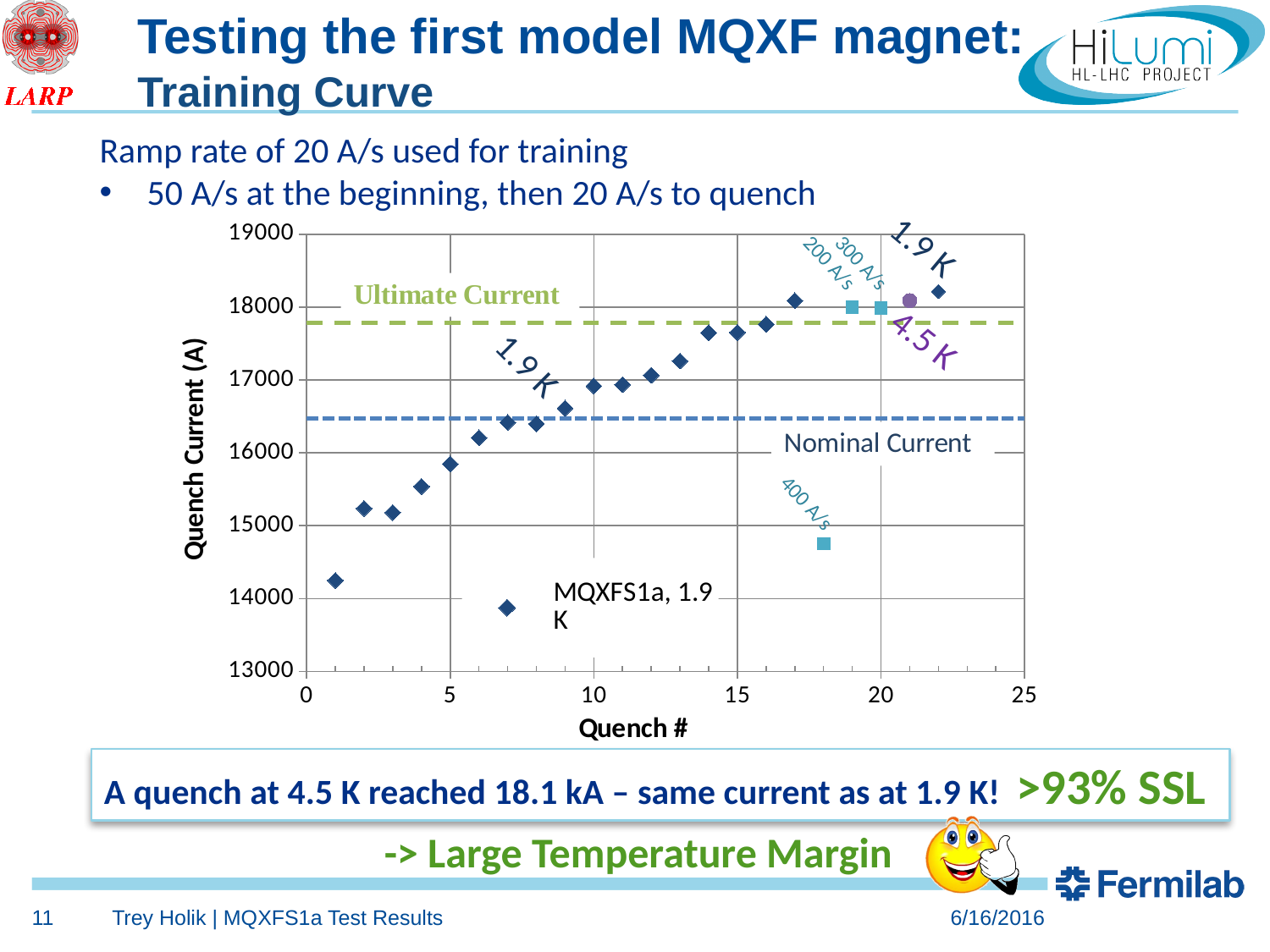
Do the quench currents of the 1.9 K diamond markers generally rise or fall as the quench number increases? rise Is the dashed 'Ultimate Current' line above or below 18000 A? below Which has the larger quench current, quench #1 or quench #2? quench #2 What kind of chart is shown on the slide? scatter chart Is the quench current for quench #1 greater or less than 15000? less Is the quench current for quench #9 greater or less than 16000? greater What label is given to the series of diamond markers in the chart? MQXFS1a, 1.9 K What is the title of the y axis of the chart? Quench Current (A) At which quench number does the lowest plotted quench current occur? 1